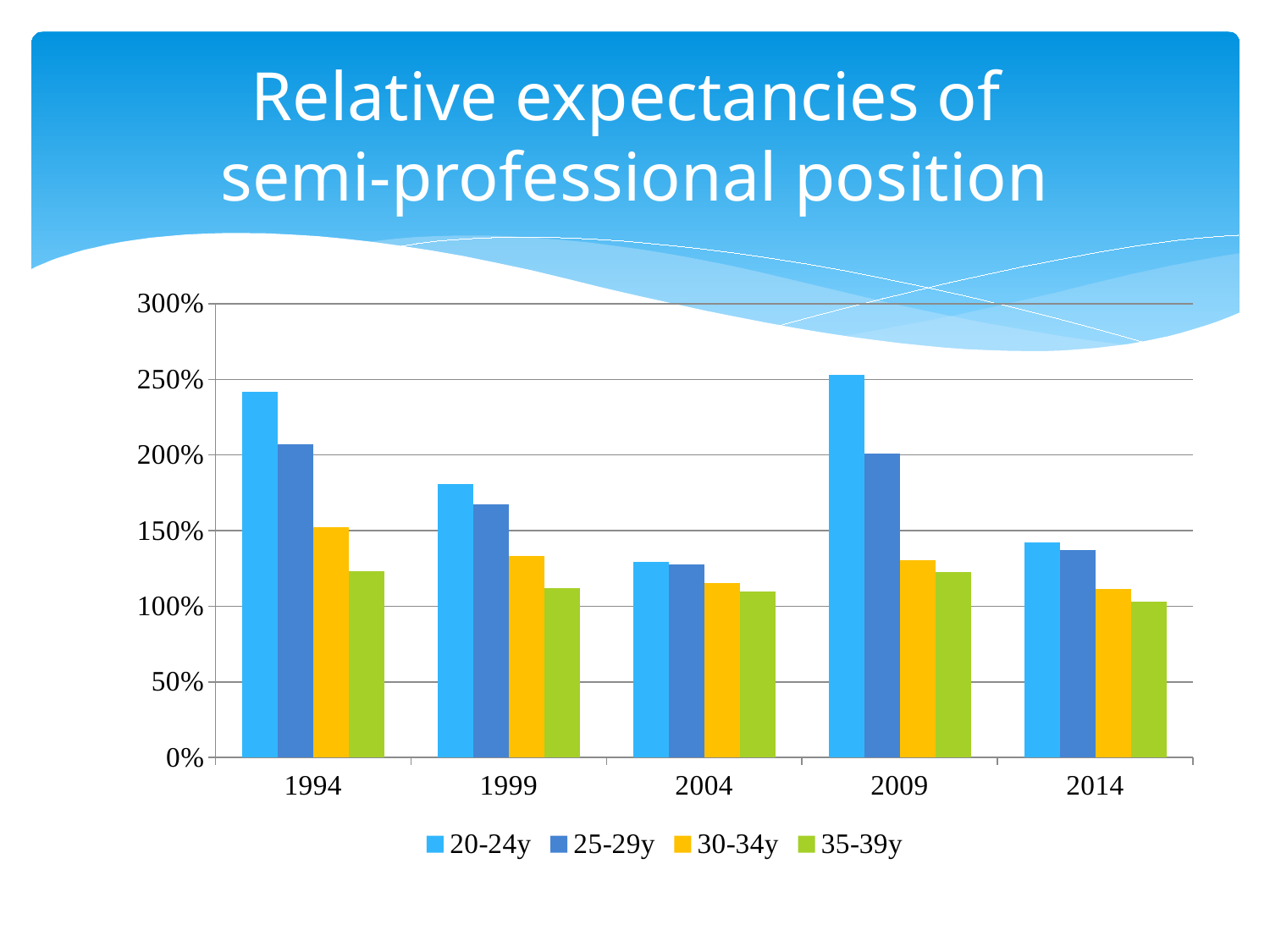
Is the value for 20-24y in 1994 greater or less than 200%? greater In which year is the 20-24y bar the highest? 2009 Is the value for 35-39y in 2014 greater or less than 150%? less What is the title of the chart? Relative expectancies of semi-professional position Is the value for 25-29y in 2009 greater or less than 150%? greater In which year is the 20-24y bar the lowest? 2004 Which age group has the lowest bar in 2009? 35-39y How many years are shown on the x axis? 5 Does the 20-24y value rise or fall from 1994 to 2004? fall What kind of chart is shown on the slide? bar chart Which is larger, the 20-24y value in 1999 or in 2009? 2009 How many series does the legend list? 4